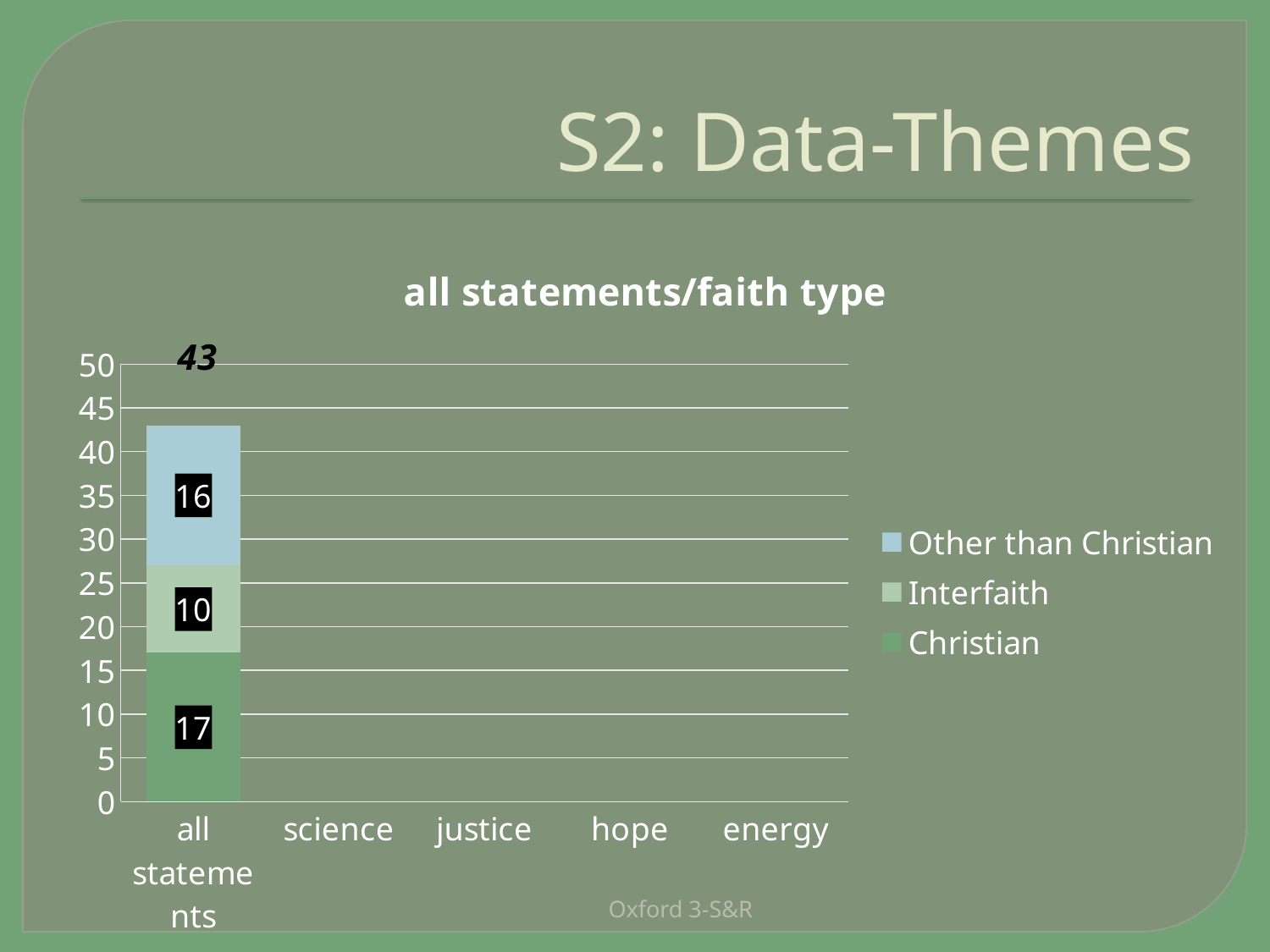
What is the title of the chart? all statements/faith type What kind of chart is shown on the slide? stacked bar chart What is the Interfaith value for the 'all statements' bar? 10 What is the Christian value for the 'all statements' bar? 17 What is the difference between the Christian and Interfaith values in the 'all statements' bar? 7 Which series has the largest segment in the 'all statements' bar? Christian How many categories are labelled on the x axis? 5 How many series does the legend list? 3 What is the total of the 'all statements' stacked bar? 43 What is the 'Other than Christian' value for the 'all statements' bar? 16 Is the Christian segment or the 'Other than Christian' segment larger in the 'all statements' bar? Christian Which series has the smallest segment in the 'all statements' bar? Interfaith